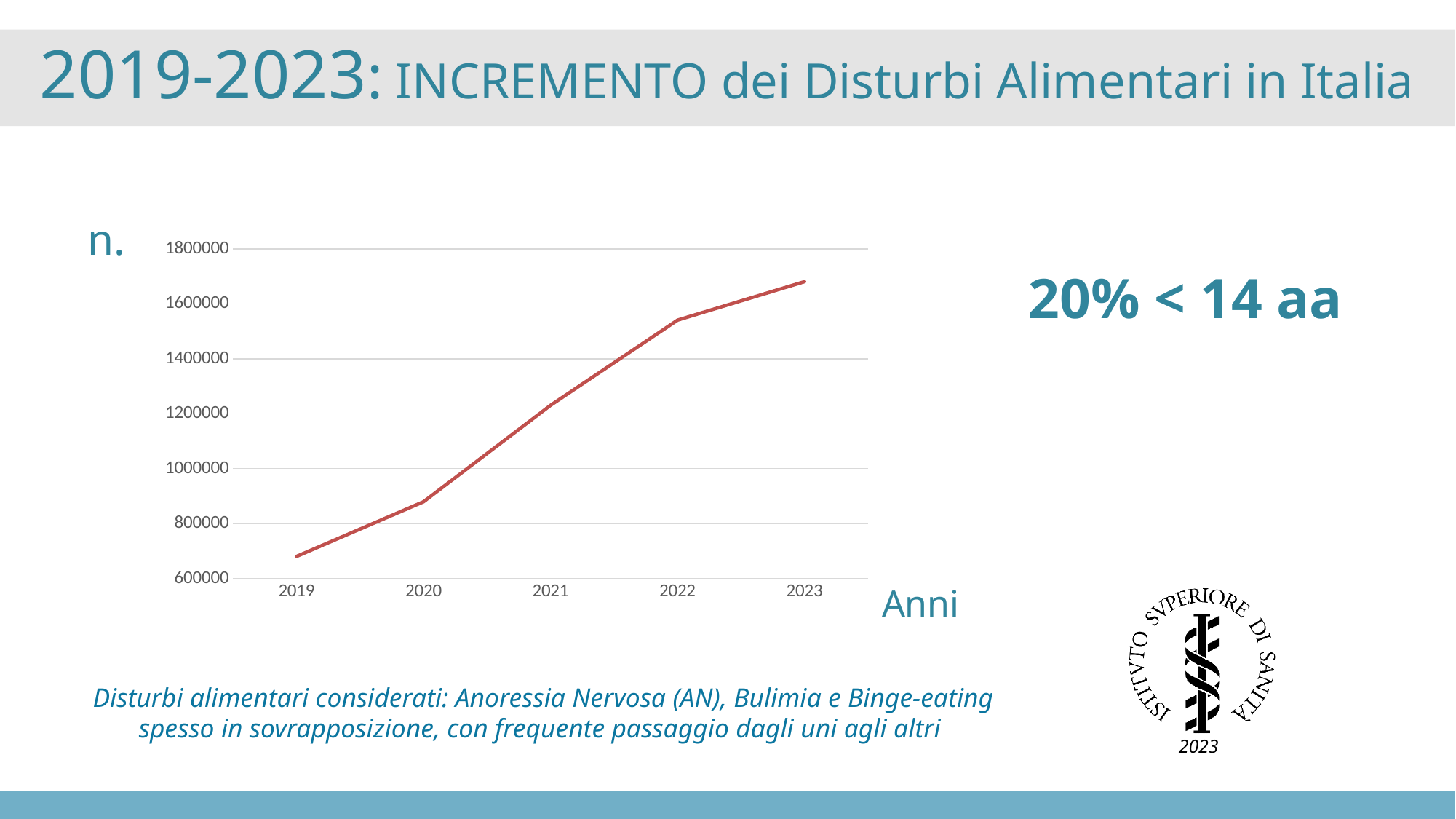
Is the value for 2020 greater or less than 1000000? less Which is larger, the value for 2021 or the value for 2020? 2021 What kind of chart is shown on the slide? line chart Which year has the lowest value on the chart? 2019 Is the value for 2021 greater or less than 1200000? greater How many years are plotted on the x axis of the chart? 5 Which year has the highest value on the chart? 2023 What label is shown on the x axis of the chart? Anni Is the value for 2019 greater or less than 800000? less Do the values rise or fall from 2019 to 2023? rise